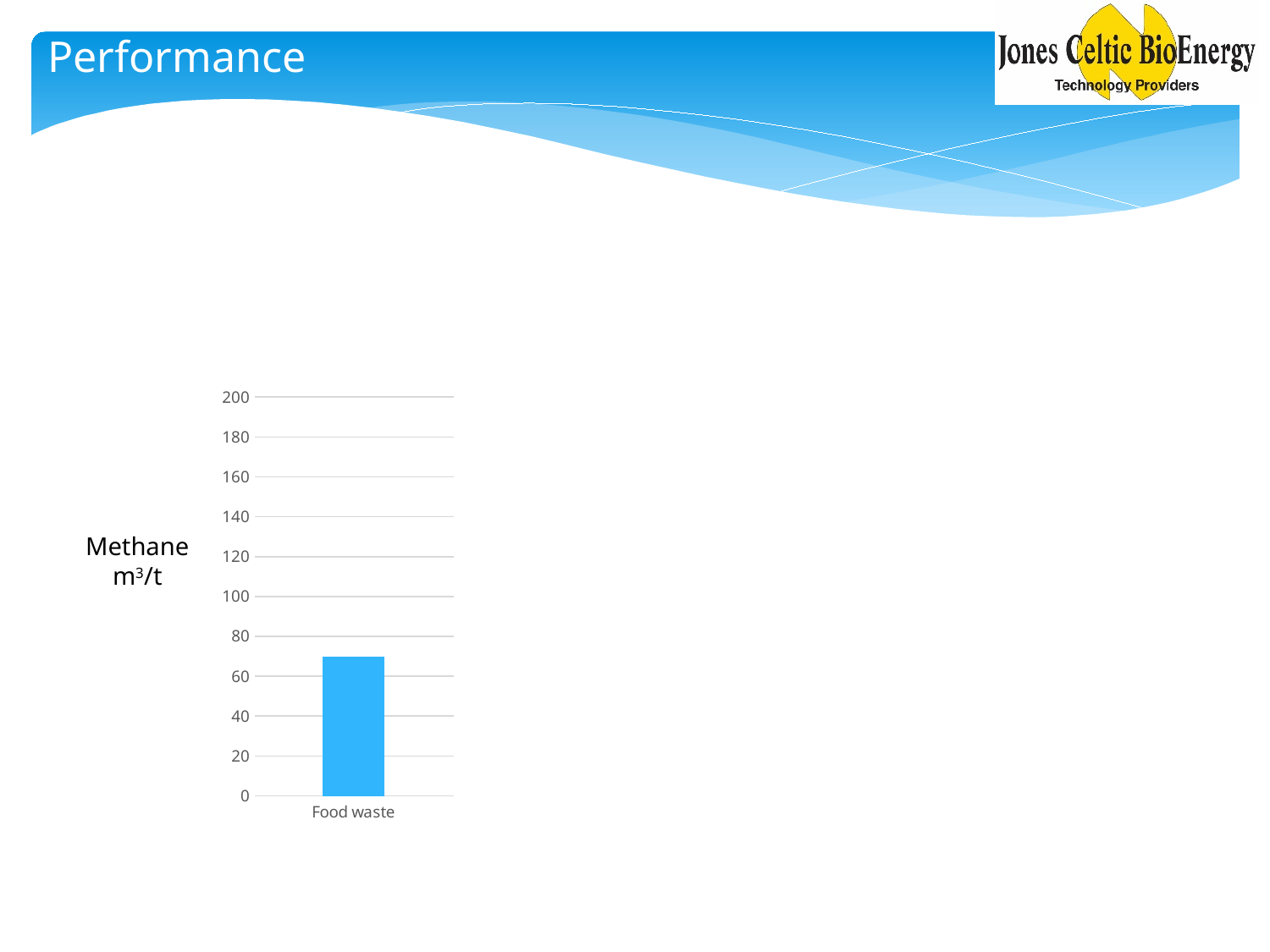
How many categories are plotted on the chart? 1 What is the label on the vertical axis of the chart? Methane m³/t Is the value for Food waste greater or less than 60? greater Is the value for Food waste greater or less than 100? less Is the value for Food waste greater or less than 40? greater What is the highest value shown on the vertical axis of the chart? 200 What is the name of the category plotted on the chart? Food waste What kind of chart is shown on the slide? bar chart